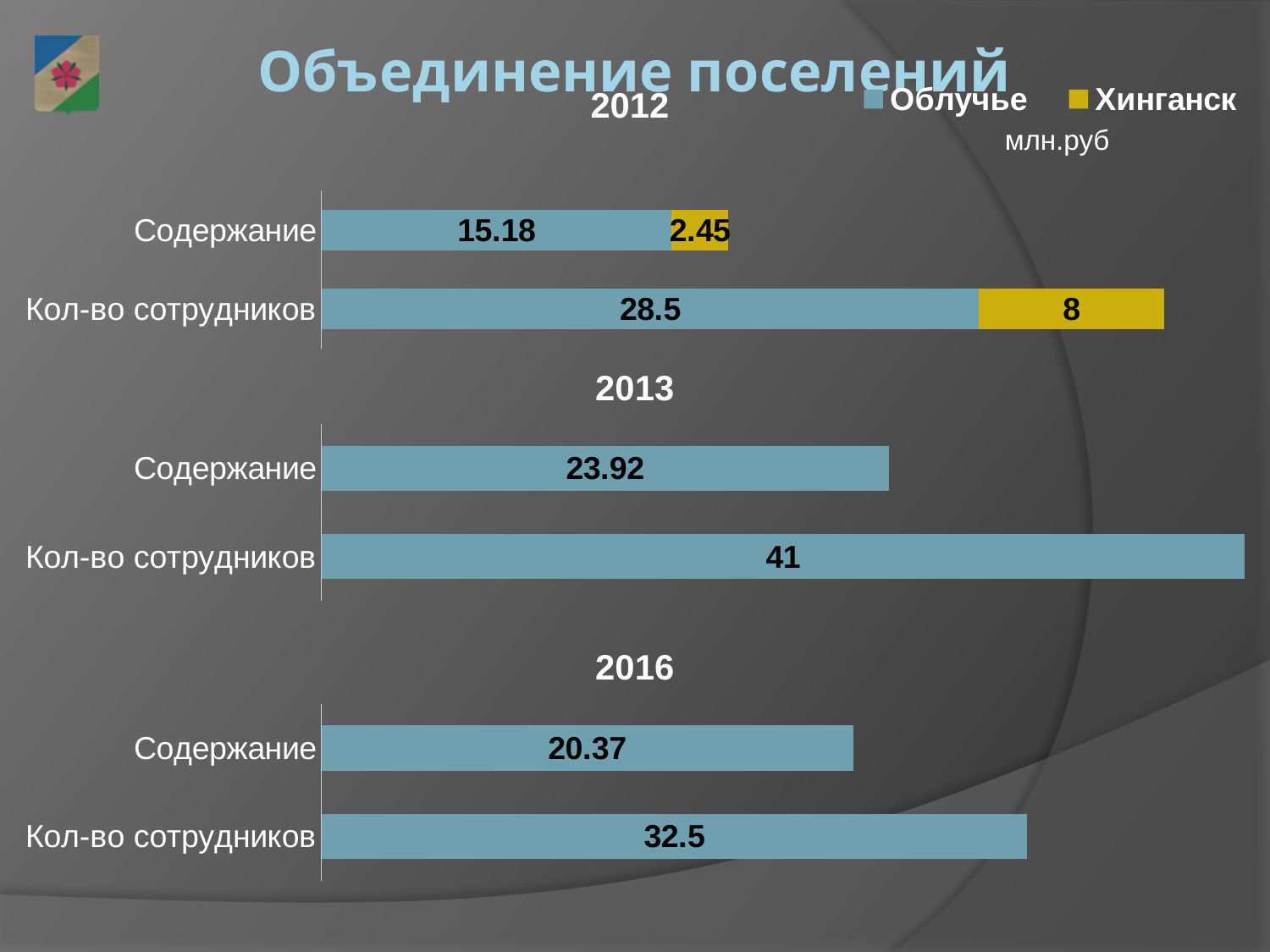
In the 2016 chart, what is the value for Содержание? 20.37 In the 2012 chart, what is the total of the stacked bar for Содержание? 17.63 In the 2016 chart, what is the difference between Кол-во сотрудников and Содержание? 12.13 In the 2012 chart, what is the total of the stacked bar for Кол-во сотрудников? 36.5 In the 2012 chart, what is the value for Хинганск in the Содержание category? 2.45 How many series does the legend list? 2 In the 2012 chart, what is the value for Облучье in the Содержание category? 15.18 What kind of chart is the 2013 chart? Bar chart In the 2016 chart, which category has the higher value, Содержание or Кол-во сотрудников? Кол-во сотрудников In the 2013 chart, what is the value for Кол-во сотрудников? 41 In the 2012 chart, what is the value for Хинганск in the Кол-во сотрудников category? 8 In the 2013 chart, what is the value for Содержание? 23.92